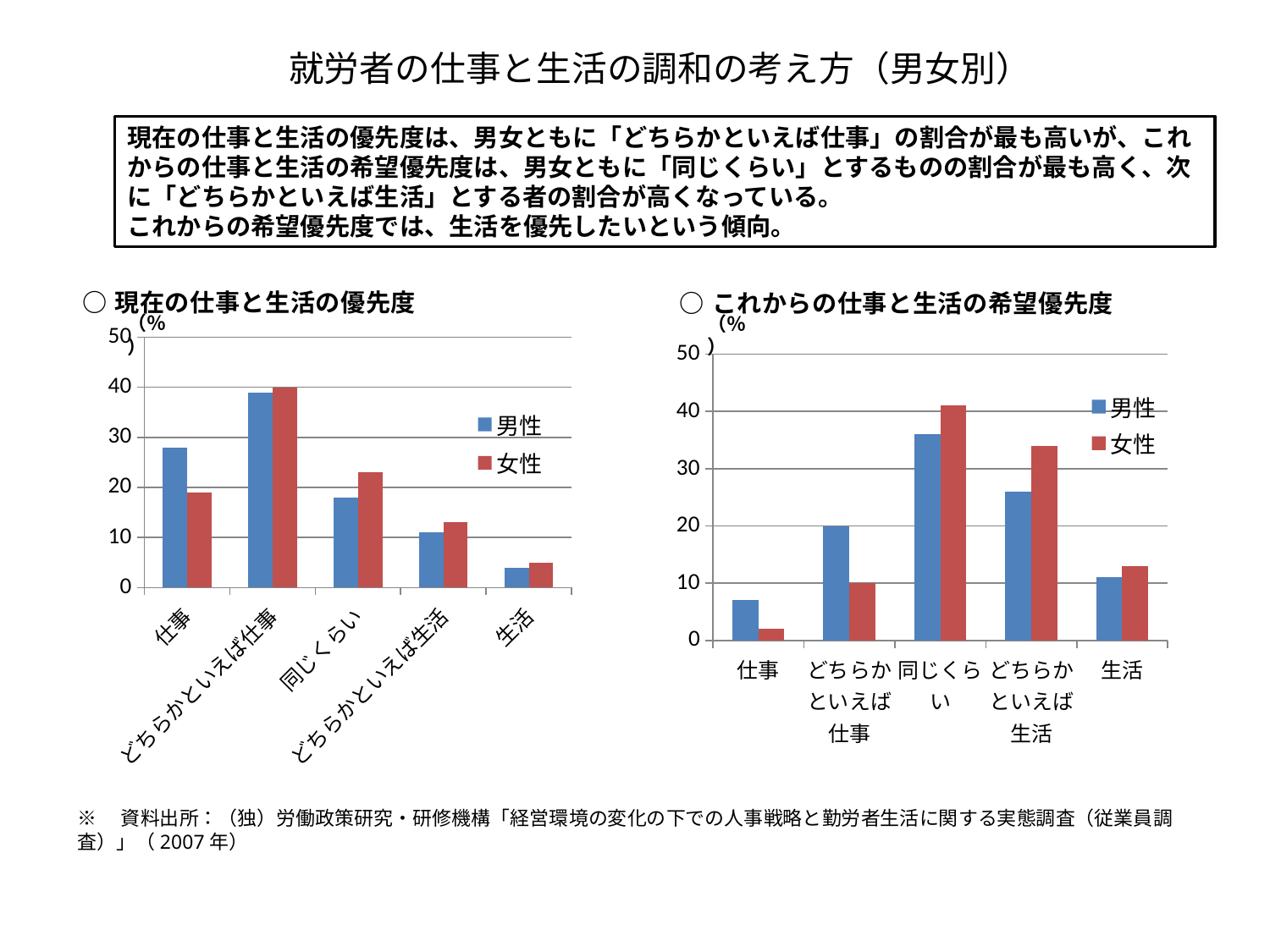
In the left chart (現在の仕事と生活の優先度), which category has the highest value for 男性? どちらかといえば仕事 In the left chart (現在の仕事と生活の優先度), how many series does the legend list? 2 In the right chart (これからの仕事と生活の希望優先度), which is larger for 仕事: 男性 or 女性? 男性 In the left chart (現在の仕事と生活の優先度), which category has the lowest value for 女性? 生活 In the left chart (現在の仕事と生活の優先度), which is larger for 同じくらい: 男性 or 女性? 女性 In the right chart (これからの仕事と生活の希望優先度), which category has the lowest value for 男性? 仕事 In the left chart (現在の仕事と生活の優先度), is the value for 男性 in 仕事 greater or less than 20? greater In the right chart (これからの仕事と生活の希望優先度), what colour represents 女性 in the legend? red In the right chart (これからの仕事と生活の希望優先度), how many categories are shown on the x axis? 5 In the right chart (これからの仕事と生活の希望優先度), which category has the highest value for 女性? 同じくらい In the left chart (現在の仕事と生活の優先度), what kind of chart is shown? bar chart